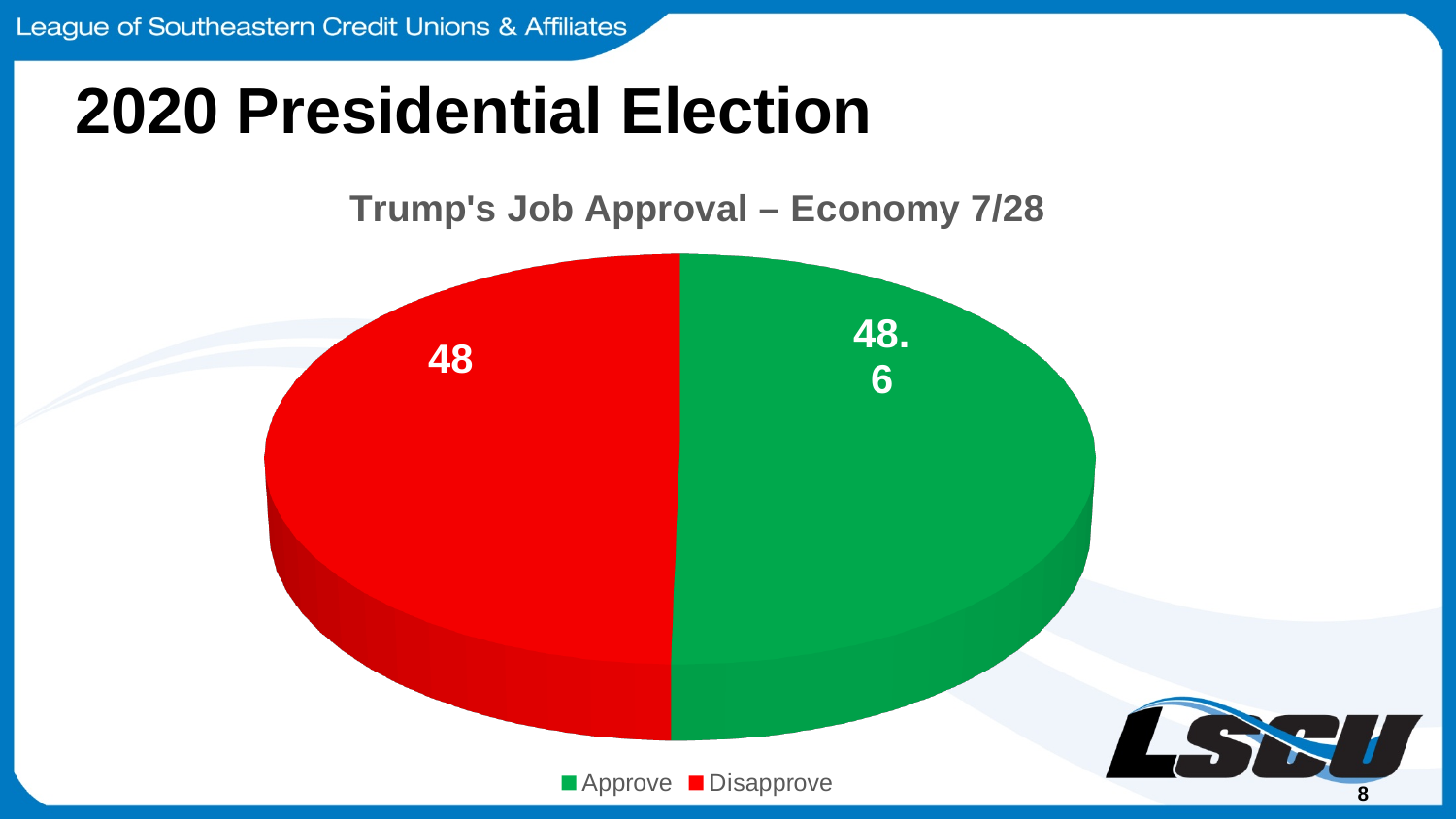
What is the difference between the Approve value and the Disapprove value? 0.6 What kind of chart is shown on the slide? Pie chart What is the value shown for the Approve slice? 48.6 What is the title of the pie chart? Trump's Job Approval – Economy 7/28 Which slice has the larger value, Approve or Disapprove? Approve Which category has the lowest value in the pie chart? Disapprove How many entries does the legend list? 2 What is the value shown for the Disapprove slice? 48 How many slices does the pie chart have? 2 Which category has the highest value in the pie chart? Approve What colour is the Disapprove slice? Red